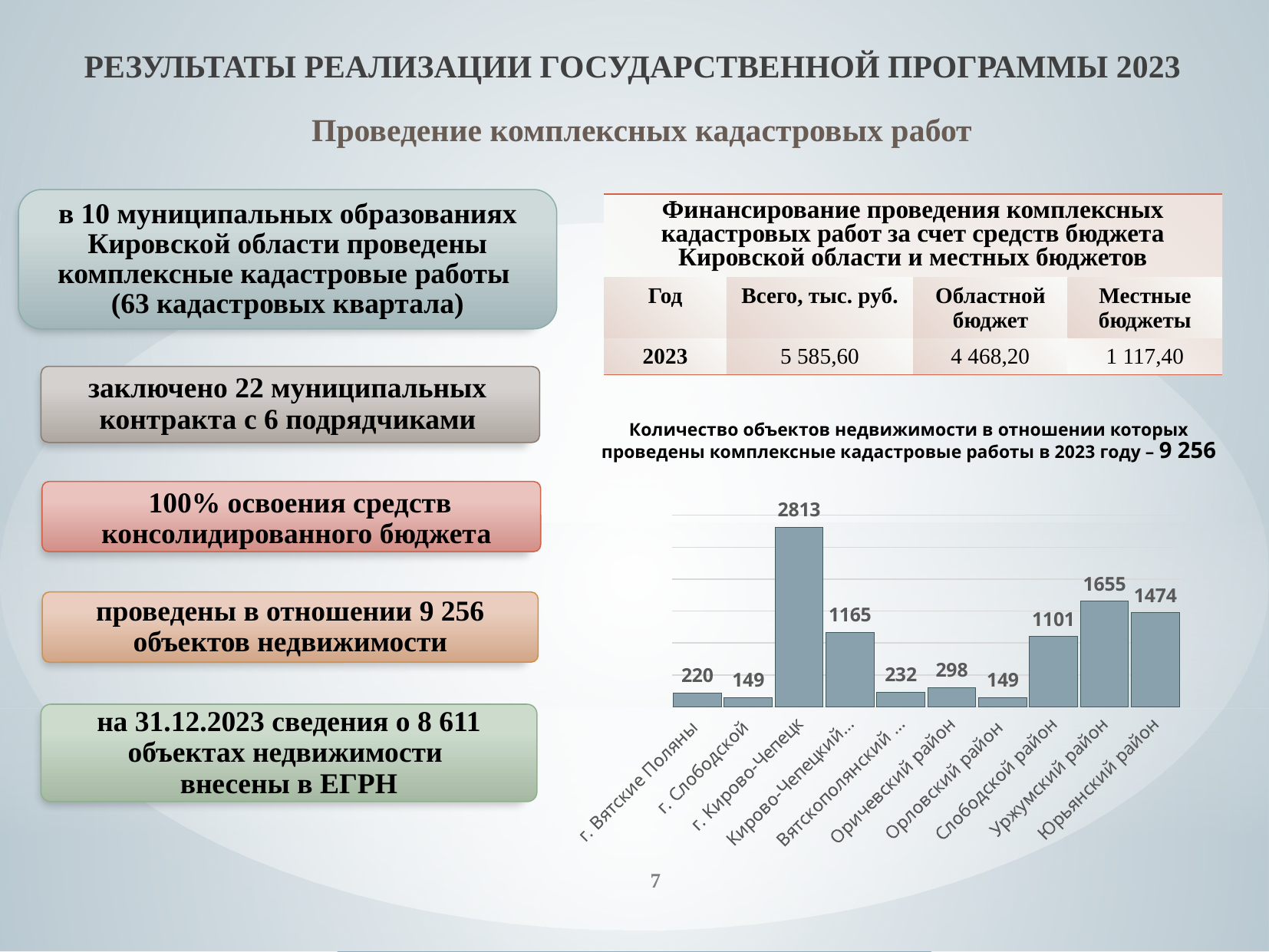
What is the value for Оричевский район in the bar chart? 298 What kind of chart is shown on the slide? bar chart What is the difference between the values for Уржумский район and Юрьянский район? 181 What is the value for г. Вятские Поляны in the bar chart? 220 What is the difference between the values for г. Кирово-Чепецк and Слободской район? 1712 How many categories are shown in the bar chart? 10 Which category has the highest value in the bar chart? г. Кирово-Чепецк Which is larger in the bar chart: г. Вятские Поляны or Оричевский район? Оричевский район What is the value for Уржумский район in the bar chart? 1655 Which is larger in the bar chart: Слободской район or Юрьянский район? Юрьянский район What is the value for Юрьянский район in the bar chart? 1474 What is the value for г. Кирово-Чепецк in the bar chart? 2813